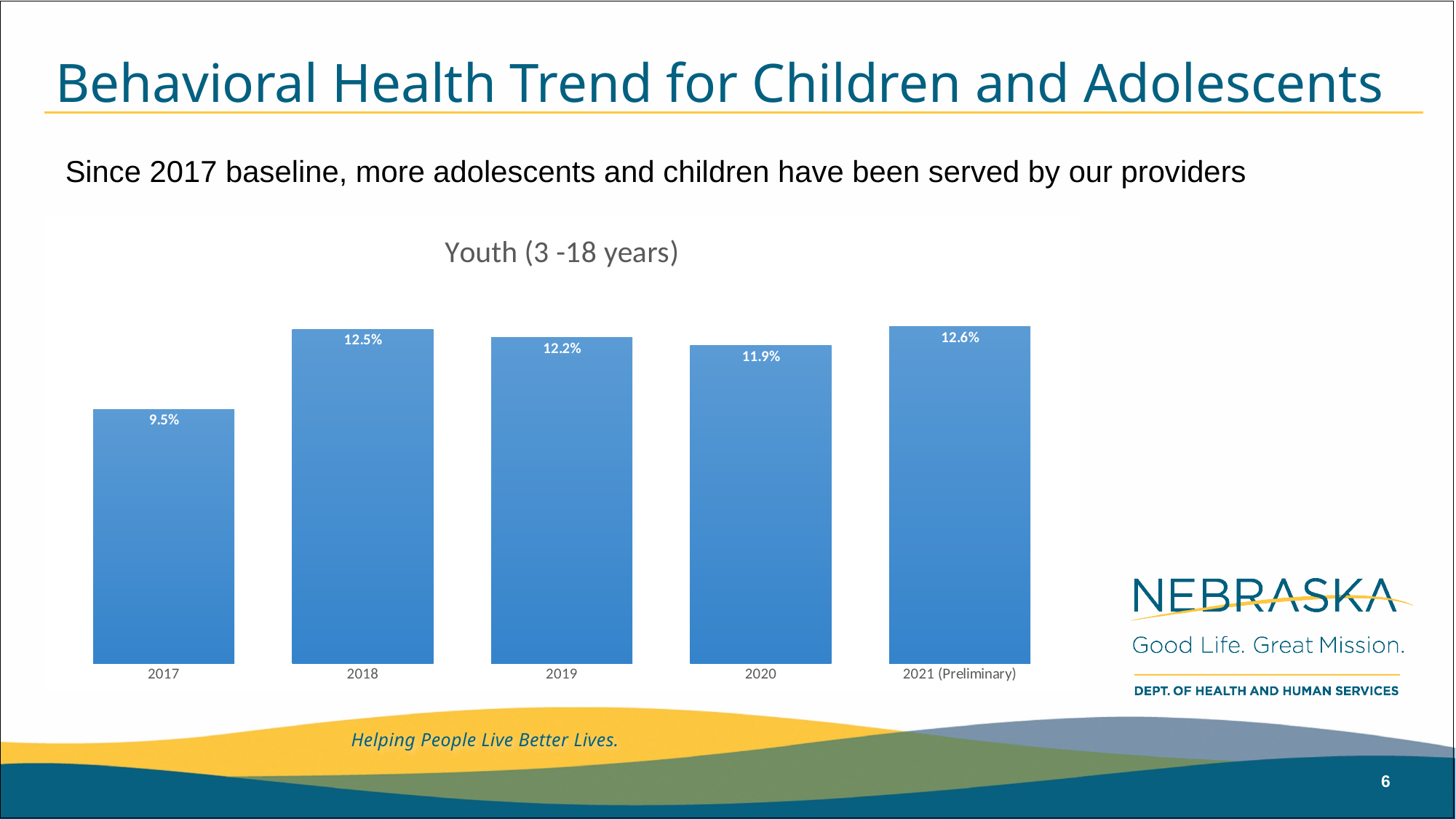
Which is larger, the value for 2019 or the value for 2020? 2019 What is the value for 2018? 12.5% What is the value for 2021 (Preliminary)? 12.6% What is the difference between the values for 2018 and 2017? 3.0% How many years are shown on the chart? 5 What is the difference between the values for 2019 and 2020? 0.3% What is the value for 2017? 9.5% What kind of chart is shown? bar chart What is the title of the chart? Youth (3 -18 years) What is the value for 2020? 11.9% Which year has the lowest value? 2017 Does the value rise or fall from 2017 to 2018? rise